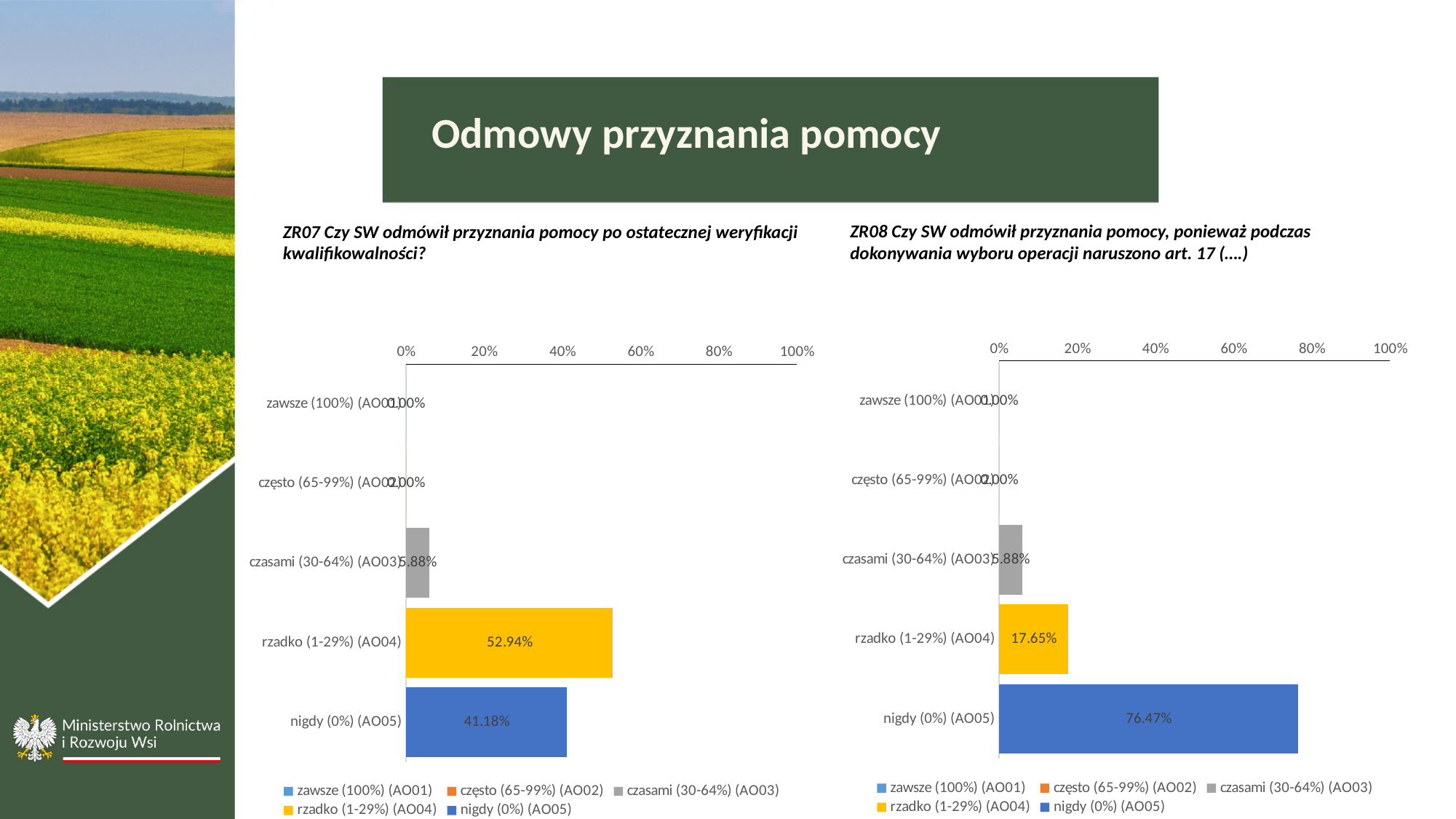
In the ZR07 chart (left), what is the value for rzadko (1-29%) (AO04)? 52.94% In the ZR08 chart (right), which is larger: the value for nigdy (0%) (AO05) or rzadko (1-29%) (AO04)? nigdy (0%) (AO05) In the ZR07 chart (left), which category has the highest value? rzadko (1-29%) (AO04) In the ZR08 chart (right), what is the difference between the values for nigdy (0%) (AO05) and rzadko (1-29%) (AO04)? 58.82% In the ZR08 chart (right), what is the value for rzadko (1-29%) (AO04)? 17.65% In the ZR07 chart (left), what is the difference between the values for rzadko (1-29%) (AO04) and nigdy (0%) (AO05)? 11.76% In the ZR08 chart (right), which category has the highest value? nigdy (0%) (AO05) In the ZR08 chart (right), what is the value for nigdy (0%) (AO05)? 76.47% What kind of chart is the ZR08 chart (right)? bar chart In the ZR07 chart (left), what is the value for nigdy (0%) (AO05)? 41.18% In the ZR08 chart (right), what is the value for czasami (30-64%) (AO03)? 5.88% How many categories does the ZR07 chart (left) show? 5